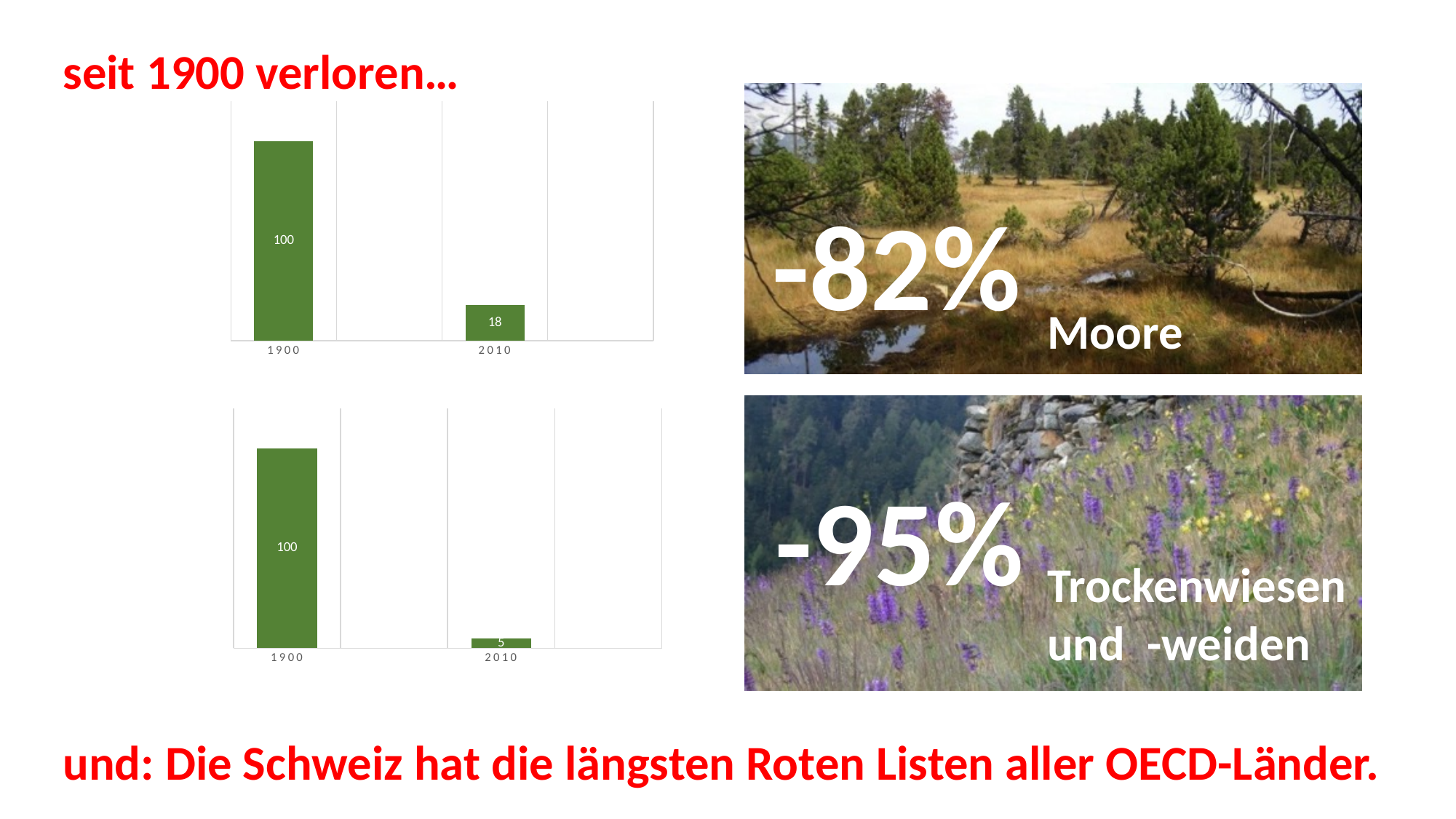
In the top chart, do the values rise or fall from 1900 to 2010? fall In the top chart, which category has the lowest value? 2010 What kind of chart is the bottom chart? bar chart In the bottom chart, which is larger, the value for 1900 or the value for 2010? 1900 In the bottom chart, what is the difference between the 1900 and 2010 values? 95 In the top chart, what is the value for 1900? 100 In the bottom chart, what is the value for 1900? 100 In the top chart, what is the difference between the 1900 and 2010 values? 82 How many categories does the top chart show? 2 In the bottom chart, what is the value for 2010? 5 In the bottom chart, which category has the highest value? 1900 In the top chart, what is the value for 2010? 18